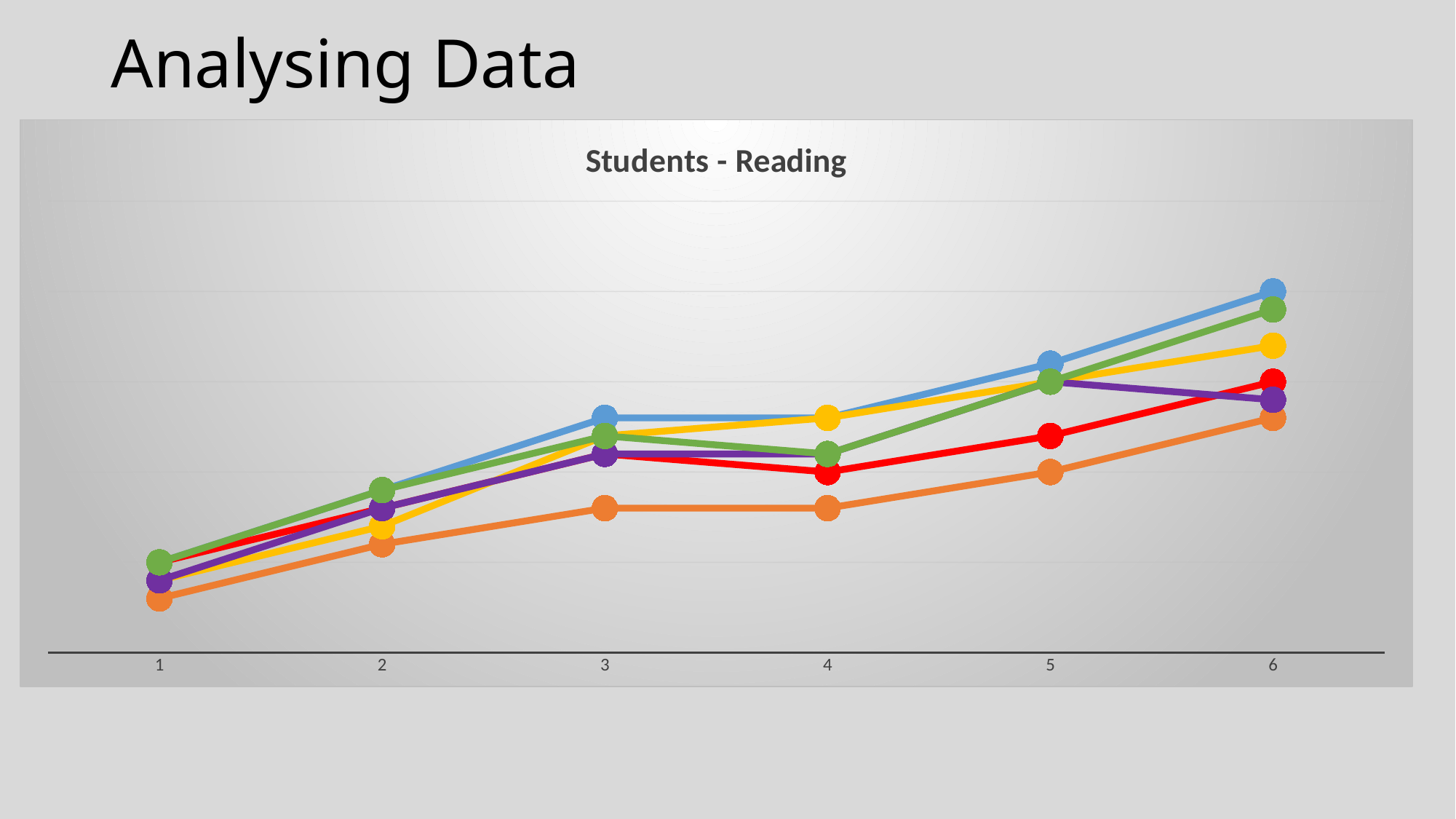
At x = 6, which is higher: the blue line or the orange line? Blue Which coloured line is lowest at x = 3? Orange Do the values on the chart generally rise or fall from x = 1 to x = 6? Rise What is the title of the chart? Students - Reading What kind of chart is shown on the slide? Line chart How many points are labelled along the x axis of the chart? 6 Which coloured line is lowest at x = 6? Orange Does the chart show a legend? No At x = 4, which is higher: the yellow line or the orange line? Yellow Which coloured line is lowest at x = 1? Orange Which coloured line is highest at x = 6? Blue How many lines are plotted on the chart? 6